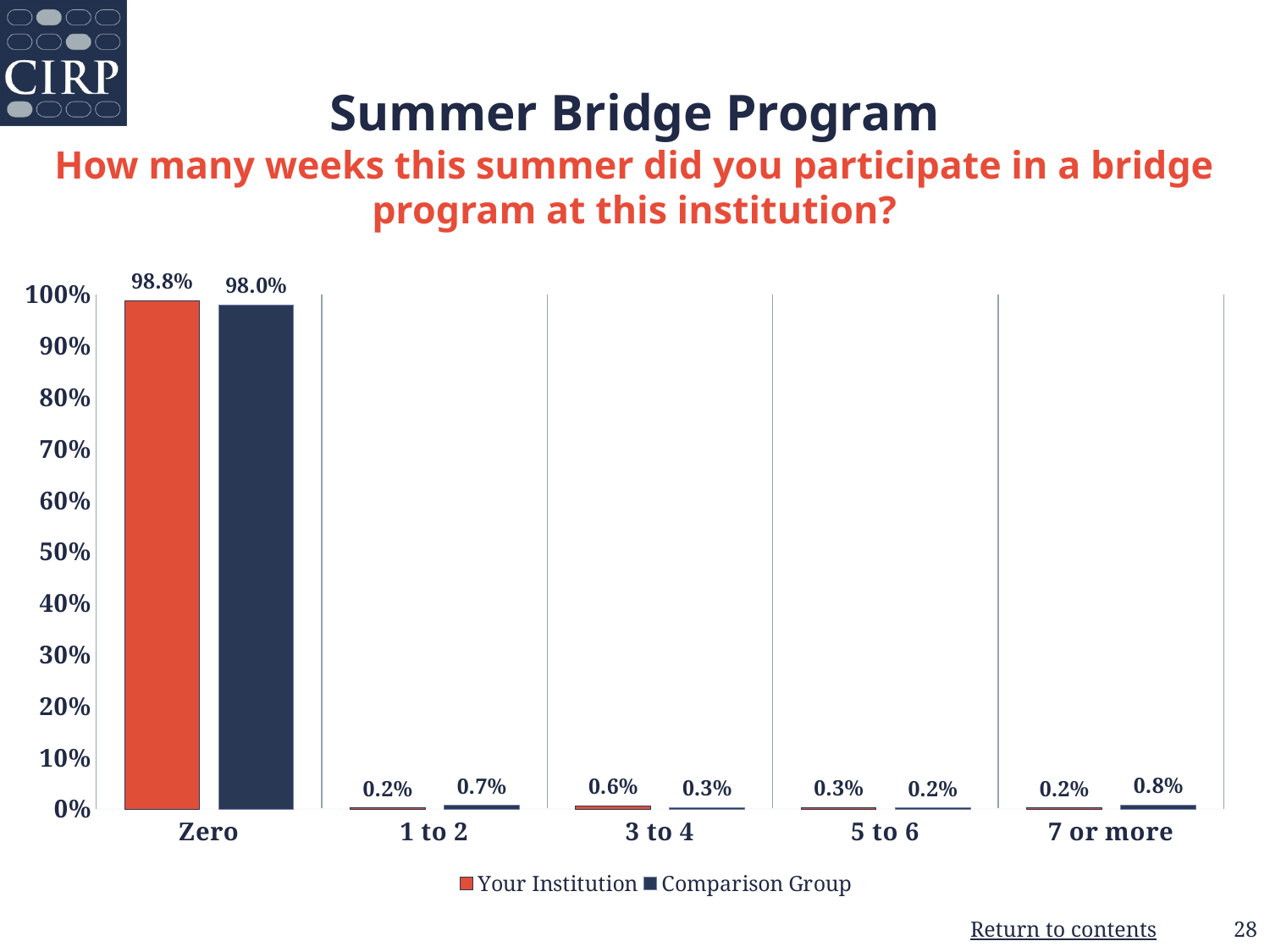
What is the value for Your Institution in the 3 to 4 category? 0.6% What is the value for Comparison Group in the 7 or more category? 0.8% What is the value for Your Institution in the Zero category? 98.8% What is the value for Comparison Group in the 1 to 2 category? 0.7% How many series does the legend list? 2 Which category has the highest value for Comparison Group? Zero Is the value for Your Institution in the Zero category greater or less than 90%? greater What is the difference between Your Institution and Comparison Group in the Zero category? 0.8% Which category has the lowest value for Your Institution? 1 to 2 and 7 or more What kind of chart is shown on the slide? bar chart Which is larger in the 3 to 4 category: Your Institution or Comparison Group? Your Institution How many categories are shown on the x axis? 5